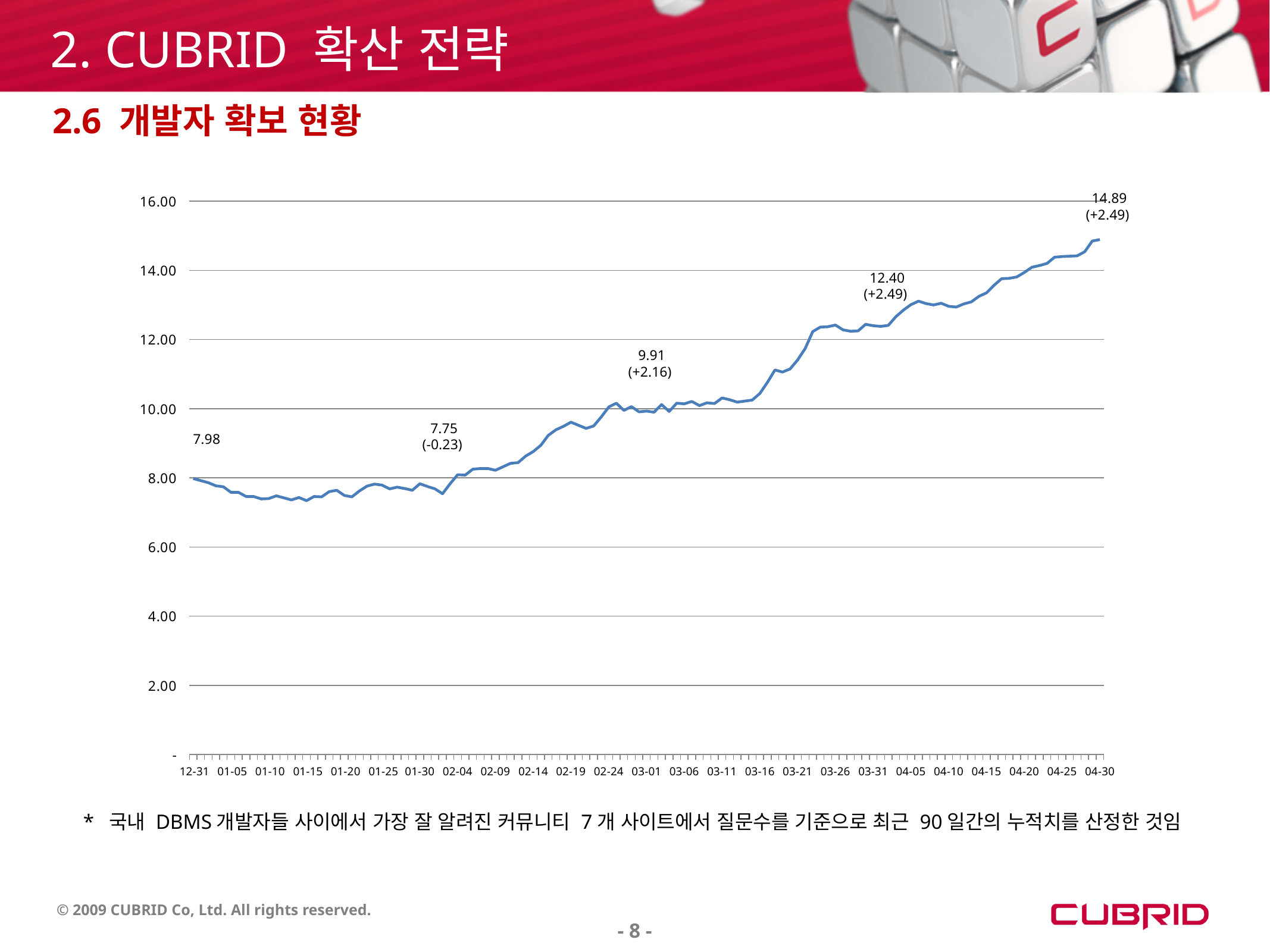
Overall, does the line rise or fall from 12-31 to 04-30? rise What is the lowest labeled value on the chart? 7.75 What is the highest labeled value on the chart? 14.89 What is the value labeled at the end of the line (04-30)? 14.89 What change is shown in parentheses next to the 12.40 label? (+2.49) Which is larger, the value labeled near 03-01 or the value labeled near 03-31? the value near 03-31 (12.40) Is the value around 01-15 greater or less than 8.00? less What change is shown in parentheses next to the 7.75 label? (-0.23) What is the value labeled near 03-01? 9.91 What is the difference between the final labeled value (14.89) and the first labeled value (7.98)? 6.91 What kind of chart is shown on the slide? line chart What is the value labeled at the start of the line (12-31)? 7.98